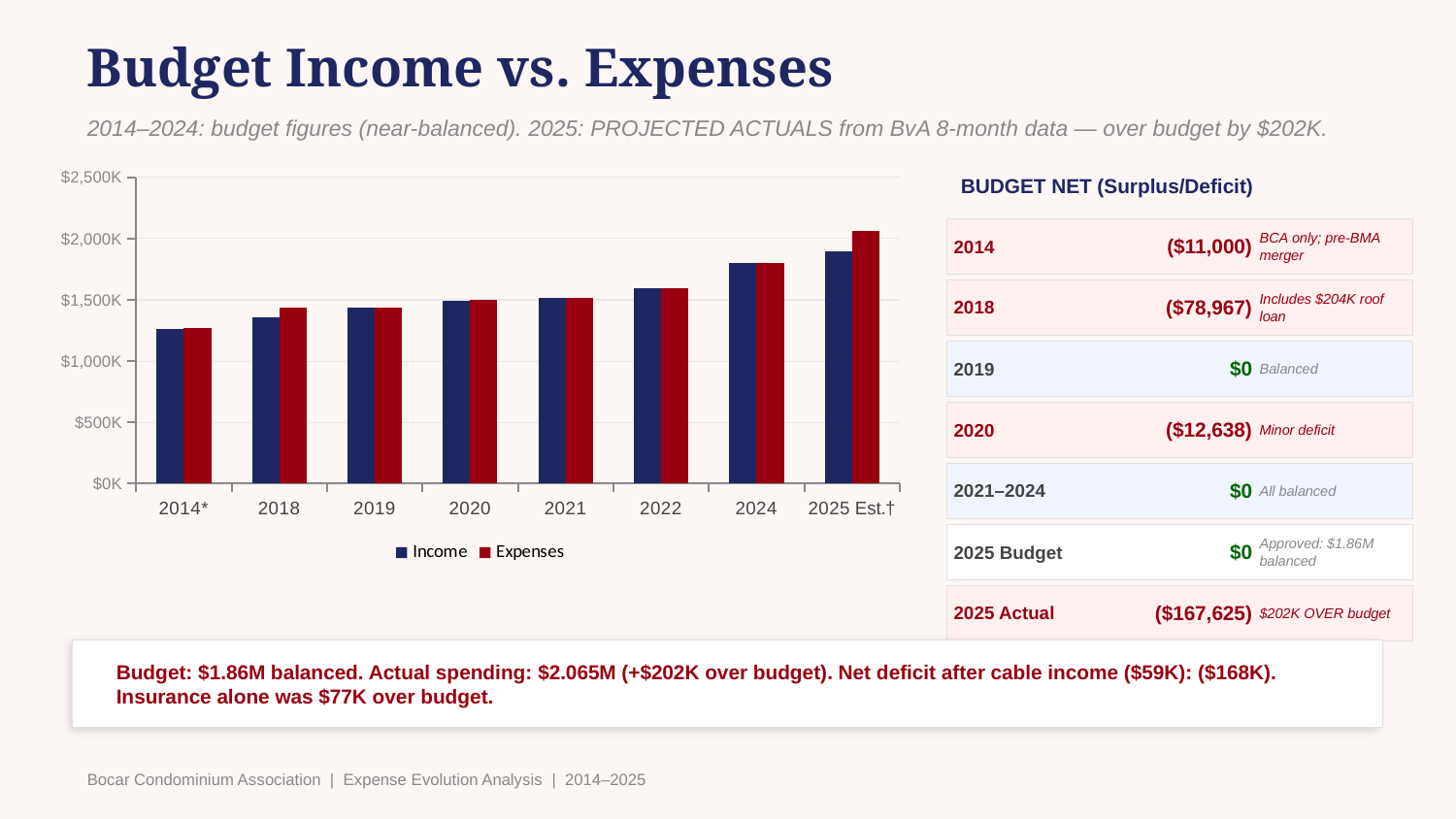
For 2025 Est.†, which is larger, Income or Expenses? Expenses What kind of chart is shown on the slide? bar chart Is the Income value for 2025 Est.† greater or less than $2,000K? less Is the Income value for 2024 greater or less than $1,500K? greater What colour are the Expenses bars in the chart? red Which year has the lowest Income bar? 2014* Is the Income value for 2014* greater or less than $1,500K? less How many year categories are shown along the x axis of the chart? 8 Do the Income values generally rise or fall from 2014* to 2025 Est.†? rise Which year has the highest Expenses bar? 2025 Est.† How many series does the chart legend list? 2